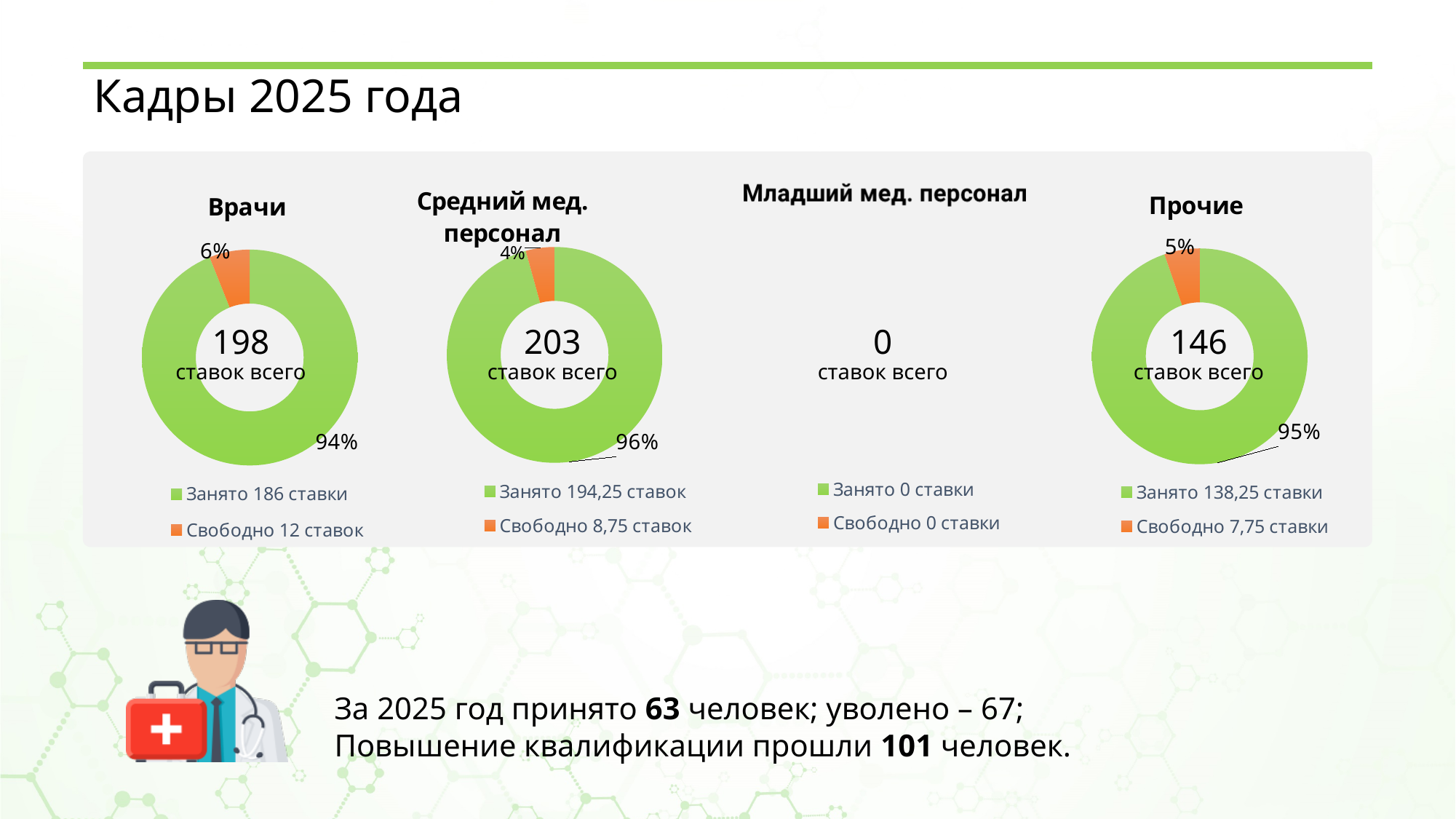
In the "Средний мед. персонал" chart legend, how many ставок are listed as Свободно? 8,75 ставок In the "Врачи" chart, which slice is larger, Занято or Свободно? Занято How many entries does the legend of the "Врачи" chart list? 2 In the "Врачи" chart, what percentage is labelled for the Свободно slice? 6% In the "Прочие" chart, how many ставок всего are shown in the centre? 146 In the "Врачи" chart, what is the difference in percentage points between the Занято and Свободно slices? 88 What kind of chart is used for the "Врачи" category? doughnut chart In the "Прочие" chart, what colour is the Занято slice? green Which staff category has the lowest number of ставок всего? Младший мед. персонал In the "Прочие" chart legend, how many ставки are listed as Занято? 138,25 ставки In the "Средний мед. персонал" chart, what percentage is labelled for the Занято slice? 96% Which staff category has the highest number of ставок всего? Средний мед. персонал